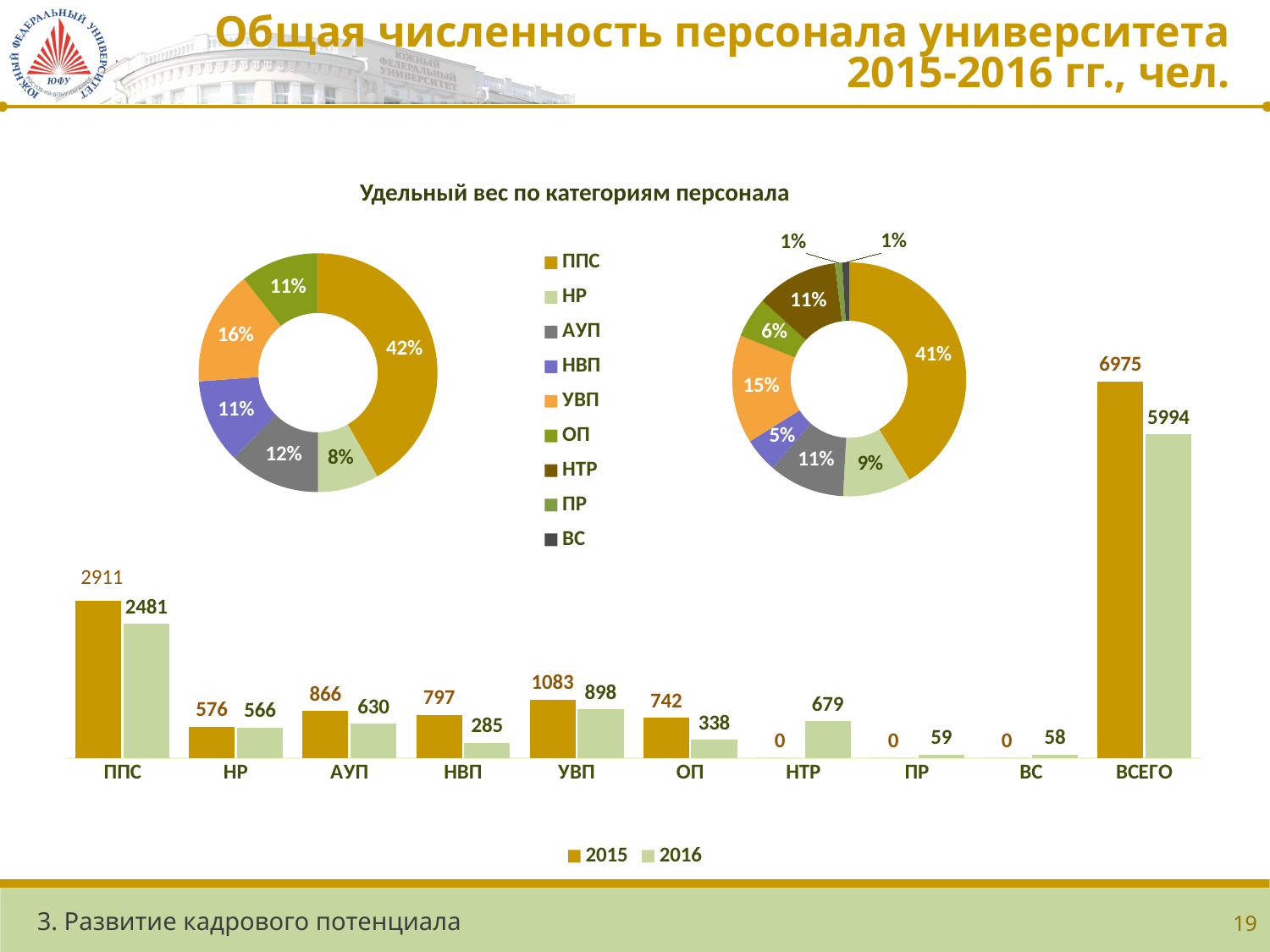
In the bar chart at the bottom, what is the 2015 value for ППС? 2911 How many series does the legend of the bar chart at the bottom list? 2 In the bar chart at the bottom, what is the 2016 value for НТР? 679 In the left donut chart, what share does ППС have? 42% In the bar chart at the bottom, which is larger for УВП: the 2015 value or the 2016 value? 2015 In the bar chart at the bottom, what is the 2016 value for ВСЕГО? 5994 In the right donut chart, what share does НВП have? 5% What type of chart is the chart at the bottom of the slide? Bar chart In the bar chart at the bottom, which category has the lowest 2016 value? ВС How many categories are shown on the x axis of the bar chart at the bottom? 10 In the bar chart at the bottom, excluding ВСЕГО, which category has the highest 2015 value? ППС In the bar chart at the bottom, what is the difference between the 2015 and 2016 values for НВП? 512